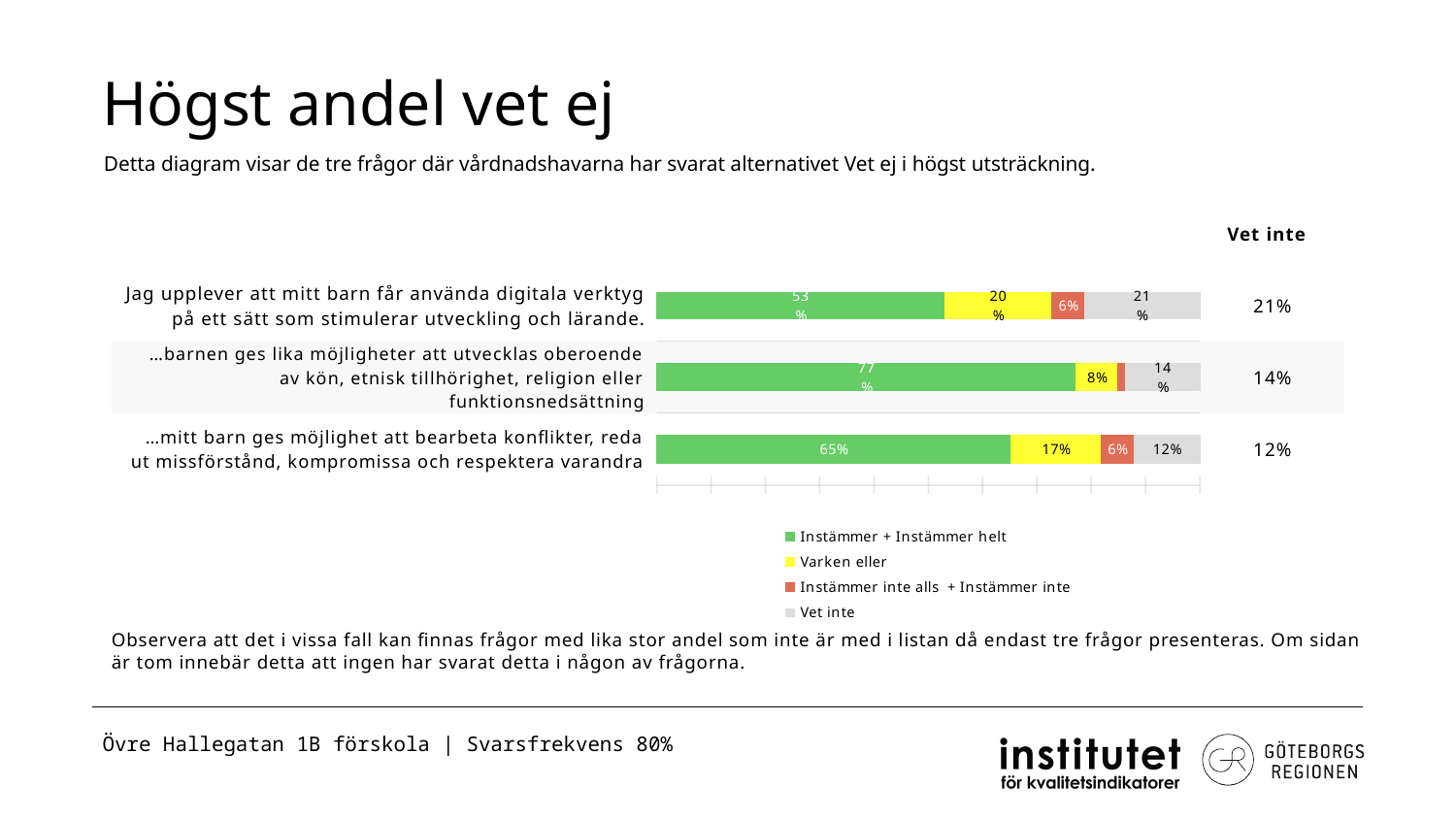
Which question has the lowest 'Instämmer + Instämmer helt' share? Jag upplever att mitt barn får använda digitala verktyg på ett sätt som stimulerar utveckling och lärande. What is the 'Varken eller' value for the question '...mitt barn ges möjlighet att bearbeta konflikter, reda ut missförstånd, kompromissa och respektera varandra'? 17% Which question has the highest 'Vet inte' share? Jag upplever att mitt barn får använda digitala verktyg på ett sätt som stimulerar utveckling och lärande. What is the 'Vet inte' value for the question '...barnen ges lika möjligheter att utvecklas oberoende av kön, etnisk tillhörighet, religion eller funktionsnedsättning'? 14% What is the title of the slide? Högst andel vet ej How many questions (categories) are plotted in the chart? 3 What is the 'Varken eller' value for the question about equal opportunities regardless of gender, ethnicity, religion or disability? 8% What is the difference between the 'Vet inte' values for the digital tools question (21%) and the conflicts question (12%)? 9% How many series does the legend list? 4 What kind of chart is shown on the slide? Stacked bar chart What is the 'Instämmer + Instämmer helt' value for the question about digital tools ('Jag upplever att mitt barn får använda digitala verktyg...')? 53% Which is larger: the 'Instämmer + Instämmer helt' share for the equal opportunities question or for the conflicts question? The equal opportunities question (77%)